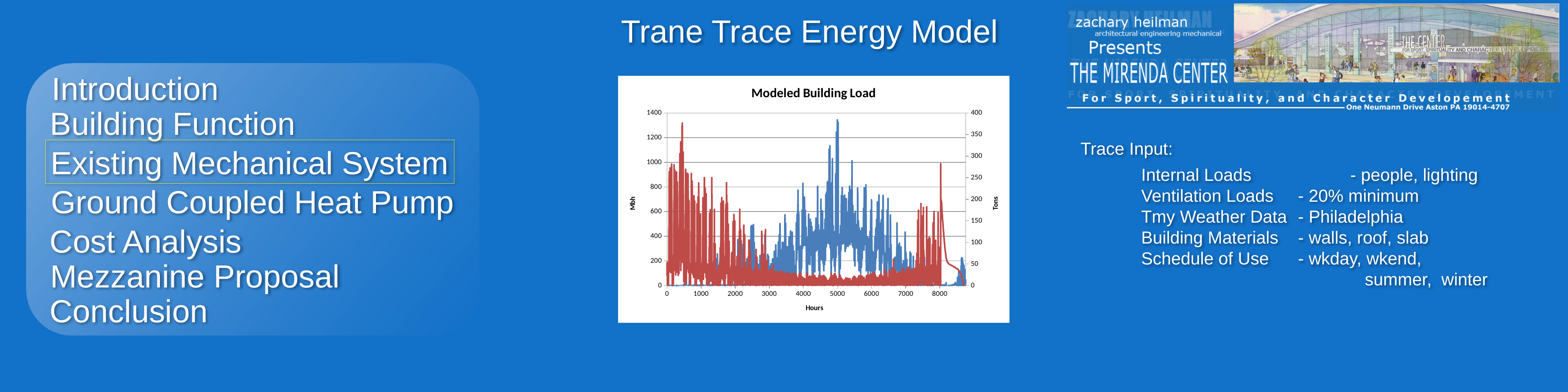
What is the label of the x axis in the Modeled Building Load chart? Hours In the Modeled Building Load chart, do the blue values rise or fall from hour 5000 toward hour 8000? fall What is the title of the chart on the slide? Modeled Building Load How many data series are plotted in the Modeled Building Load chart? 2 Reading against the left axis, are the red values around hour 4000 in the Modeled Building Load chart greater or less than 600? less In the Modeled Building Load chart, do the red values rise or fall from hour 0 toward hour 4000? fall Reading against the left axis, is the highest red peak in the Modeled Building Load chart greater or less than 1200? greater Reading against the left axis, is the highest blue peak in the Modeled Building Load chart greater or less than 1000? greater In the Modeled Building Load chart, which series has its highest values in the middle of the x axis, around hour 5000: the red or the blue series? the blue series What kind of chart is the Modeled Building Load chart? line chart